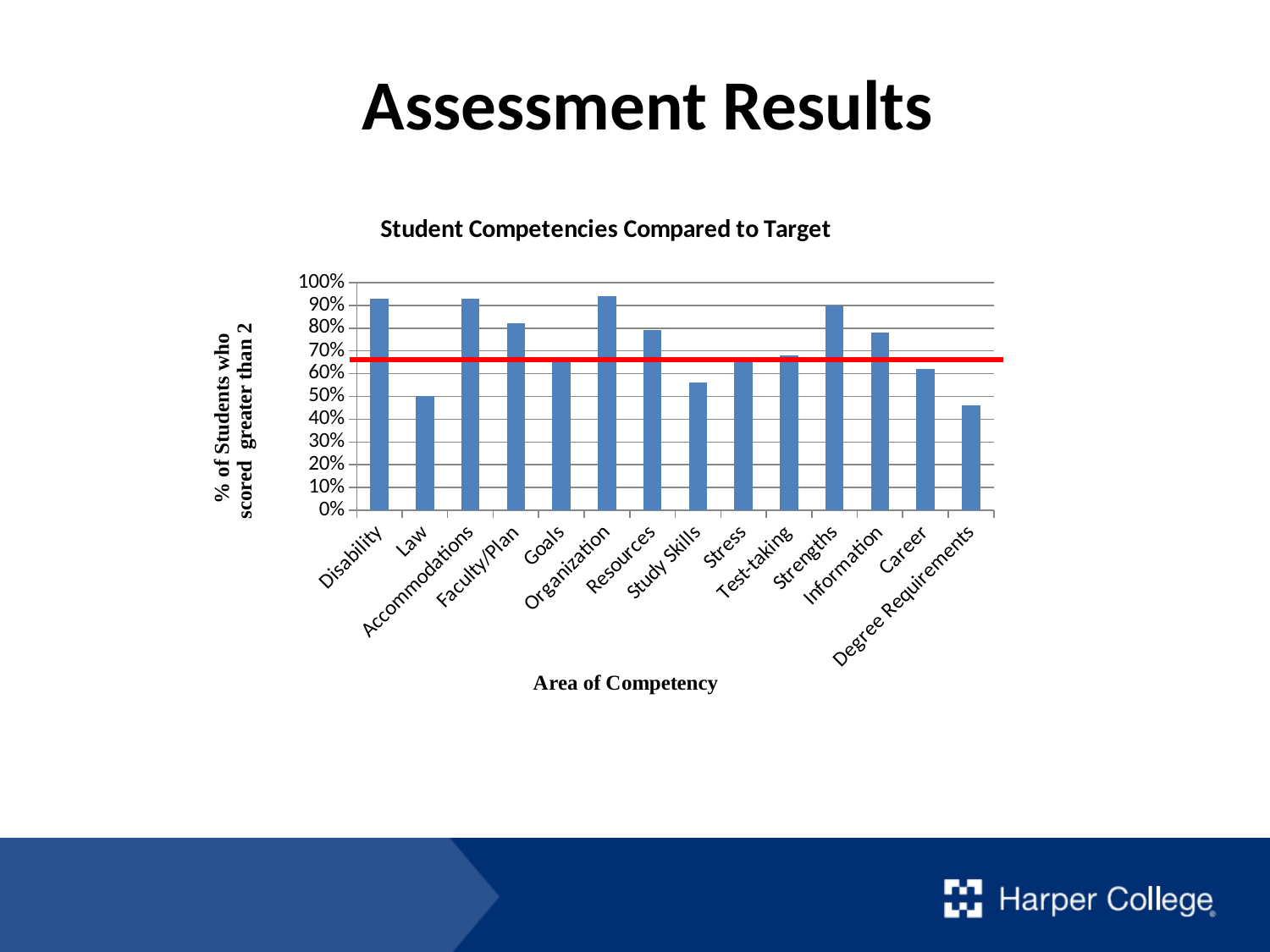
How many areas of competency are plotted on the x axis? 14 Which is larger, the value for Faculty/Plan or the value for Career? Faculty/Plan Which area of competency has the lowest bar? Degree Requirements Which is larger, the value for Disability or the value for Law? Disability Is the value for Degree Requirements greater or less than 60%? less Is the value for Strengths greater or less than 80%? greater What is the label of the x axis? Area of Competency Is the value for Study Skills greater or less than 60%? less What is the title of the chart? Student Competencies Compared to Target What kind of chart is shown on the slide? bar chart